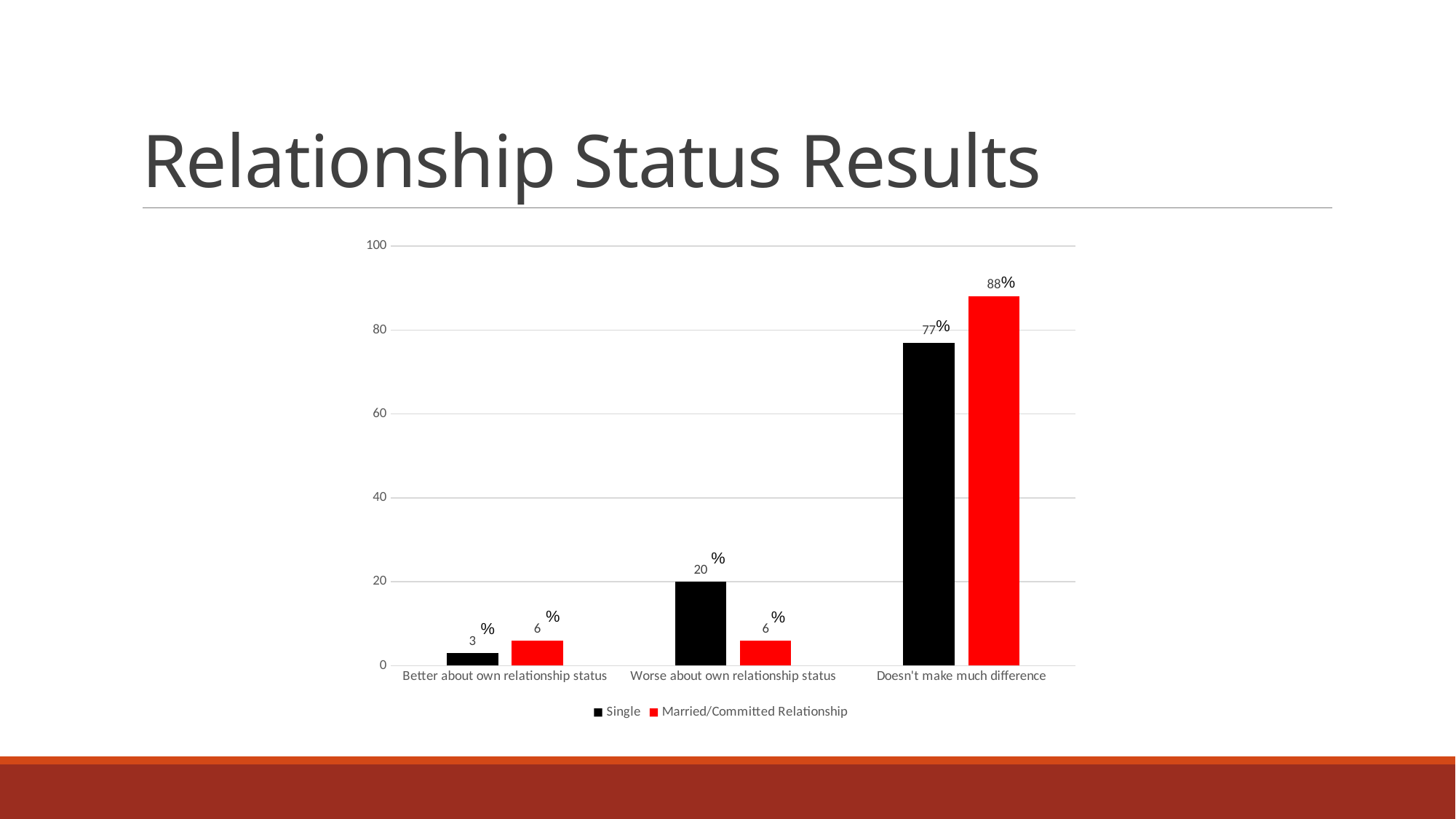
What is the value for Married/Committed Relationship in the 'Doesn't make much difference' category? 88% In the 'Worse about own relationship status' category, which series has the larger value, Single or Married/Committed Relationship? Single What colour represents the Married/Committed Relationship series? Red What is the difference between the Married/Committed Relationship and Single values in the 'Doesn't make much difference' category? 11% How many categories are shown on the x axis? 3 Which category has the highest value for the Single series? Doesn't make much difference What is the value for Single in the 'Worse about own relationship status' category? 20% How many series does the legend list? 2 What kind of chart is shown on the slide? Bar chart What is the value for Single in the 'Better about own relationship status' category? 3% Which category has the lowest value for the Single series? Better about own relationship status What is the value for Married/Committed Relationship in the 'Worse about own relationship status' category? 6%